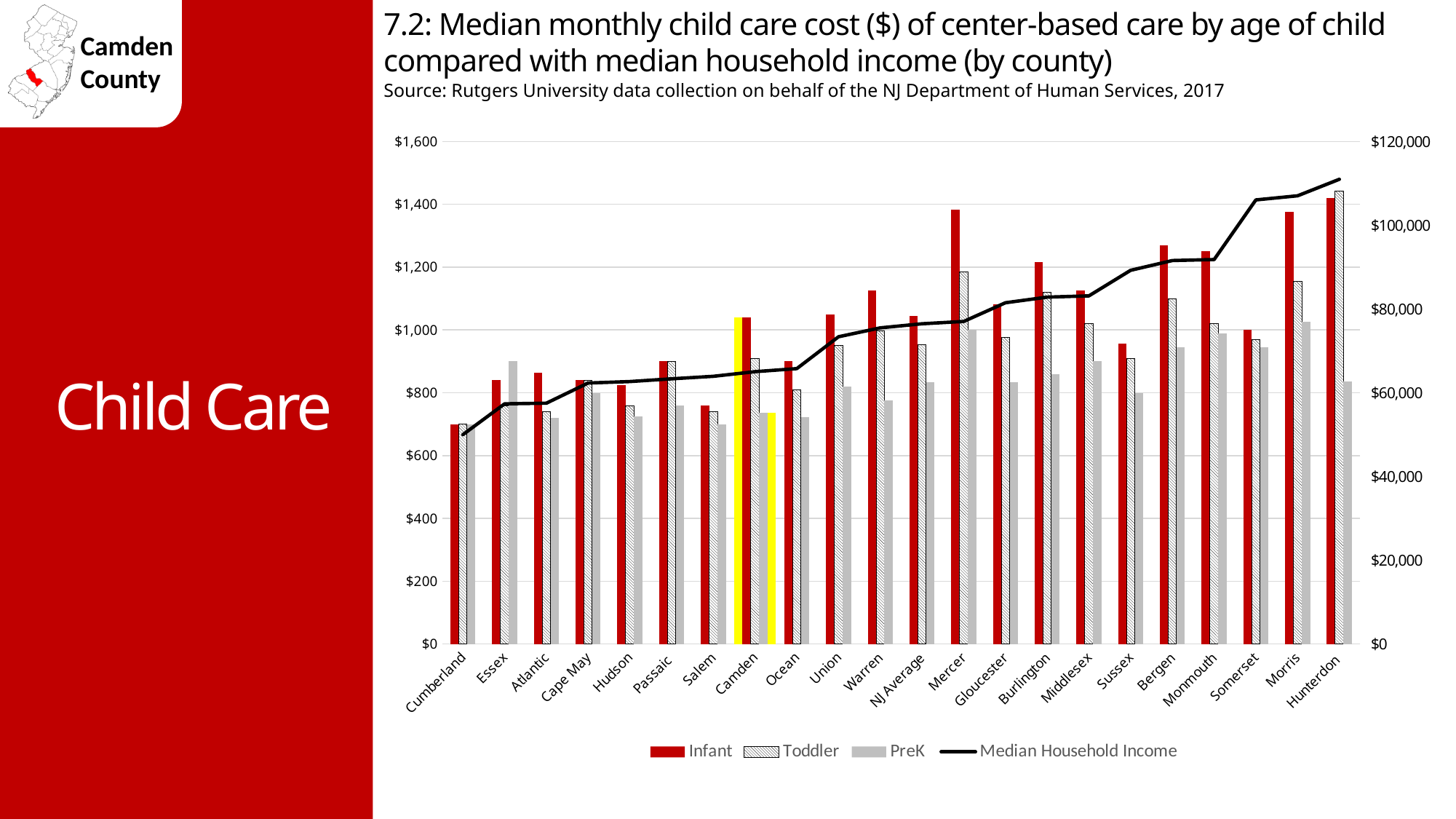
Does the Median Household Income line generally rise or fall from left to right across the counties? rise How many series does the legend list? 4 Is the Infant value for Cumberland greater or less than $800? less Which county has the lowest Infant cost? Cumberland How many categories are shown along the x axis? 22 What kind of chart is this? Bar chart with a line series Which county has the highest Toddler cost? Hunterdon Which county's bars are highlighted in yellow? Camden Is the Infant value for Mercer greater or less than $1,200? greater Is the Median Household Income for Hunterdon greater or less than $100,000? greater Which is larger, the Infant cost for Mercer or the Infant cost for Gloucester? Mercer